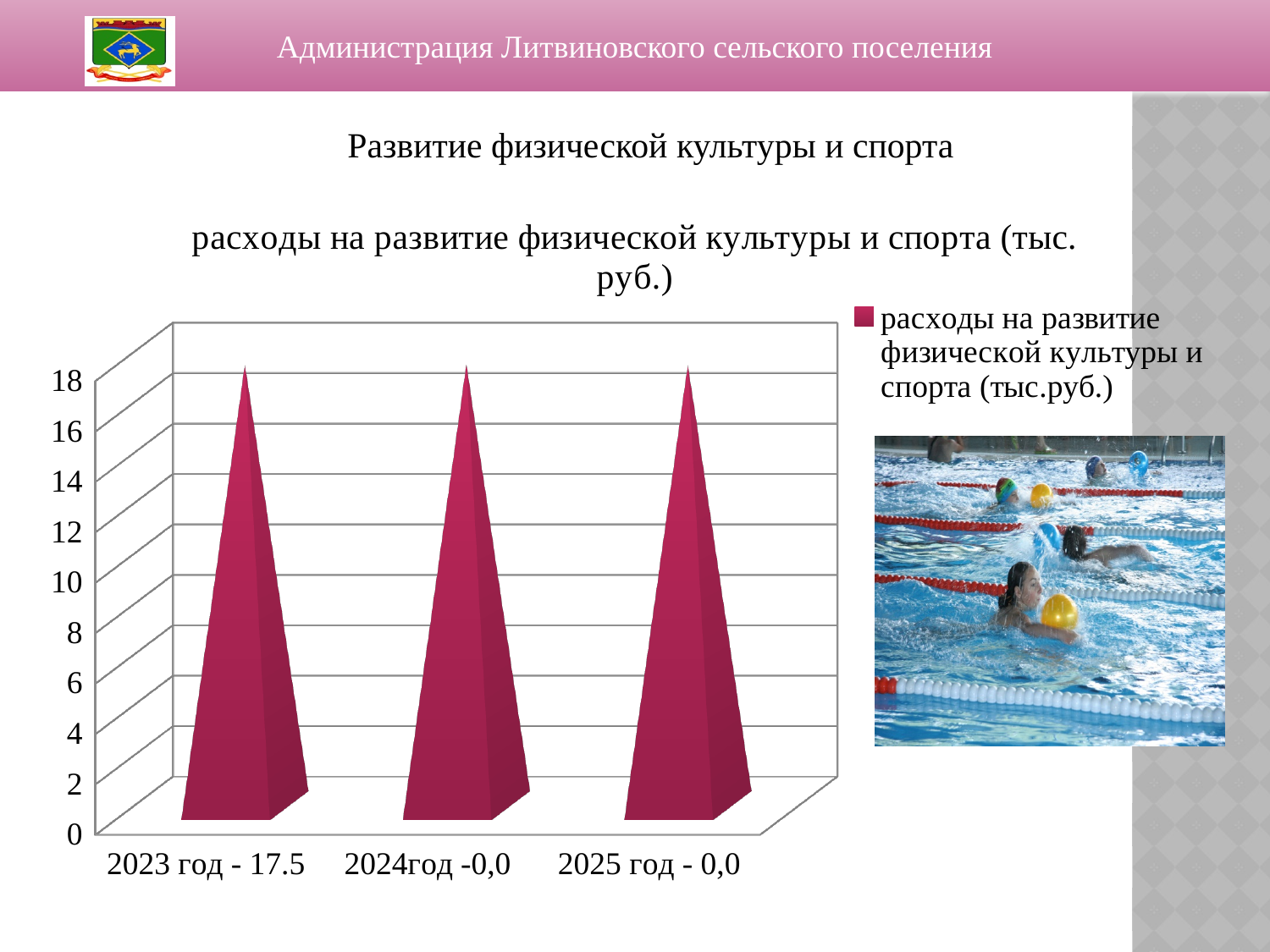
Is the bar for "2025 год - 0,0" greater or less than 14? greater Is the bar for "2023 год - 17.5" greater or less than 10? greater What is the title of the chart? расходы на развитие физической культуры и спорта (тыс. руб.) How many series does the chart legend list? 1 What kind of chart is shown on the slide? bar chart Is the bar for "2024год -0,0" greater or less than 12? greater How many categories are plotted along the x axis of the chart? 3 What is the legend entry of the chart? расходы на развитие физической культуры и спорта (тыс.руб.)